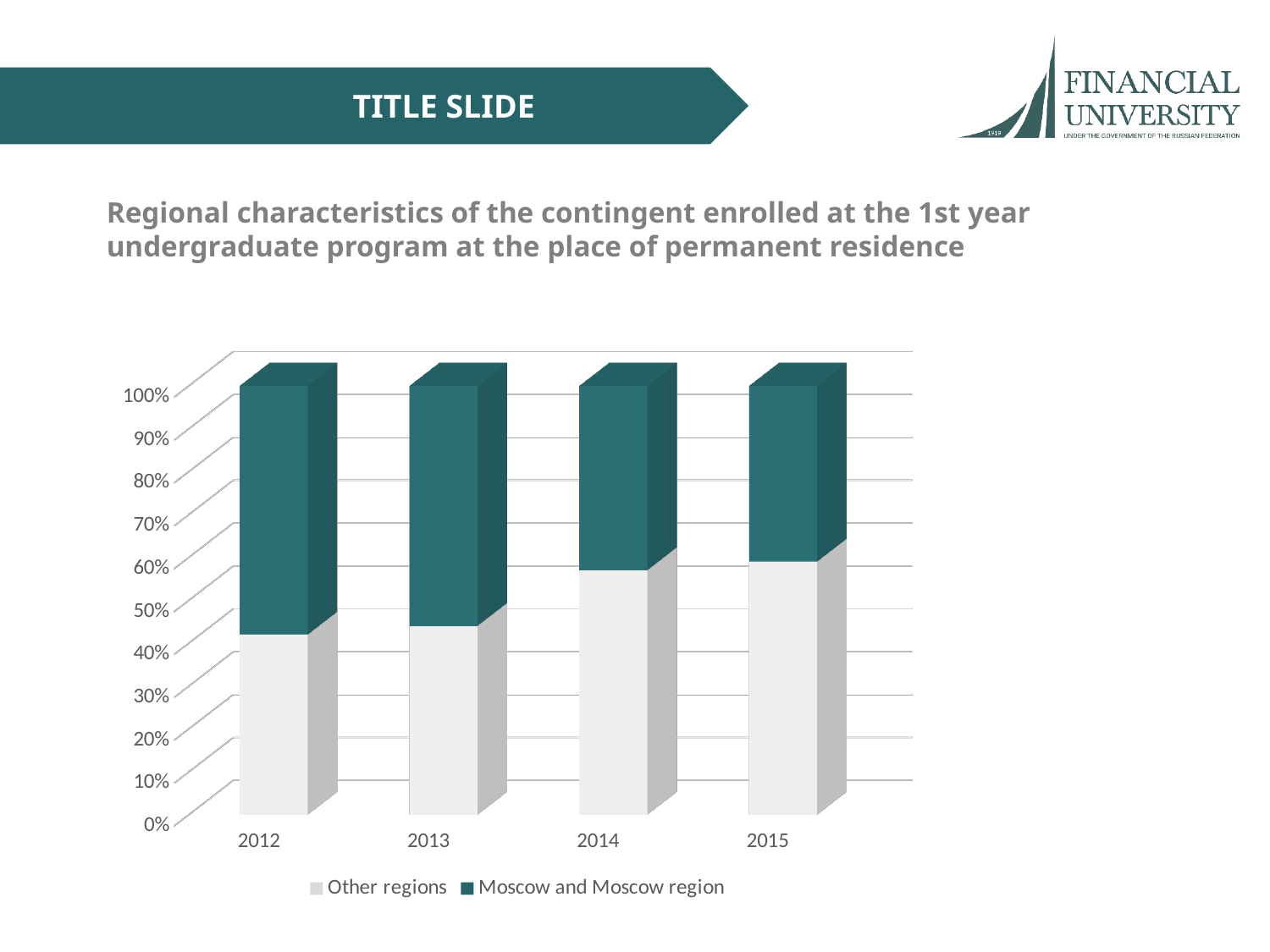
Is the share of Moscow and Moscow region in 2015 greater or less than 50%? less Does the share of Other regions rise or fall from 2012 to 2015? rise Is the share of Moscow and Moscow region in 2012 greater or less than 50%? greater How many series does the chart legend list? 2 Is the share of Other regions in 2014 greater or less than 50%? greater Which year has the larger share of Moscow and Moscow region, 2013 or 2015? 2013 What kind of chart is shown on the slide? stacked bar chart Does the share of Moscow and Moscow region rise or fall from 2012 to 2015? fall How many years are shown on the x axis of the chart? 4 Which year has the larger share of Other regions, 2012 or 2014? 2014 Which two series are listed in the chart legend? Other regions; Moscow and Moscow region